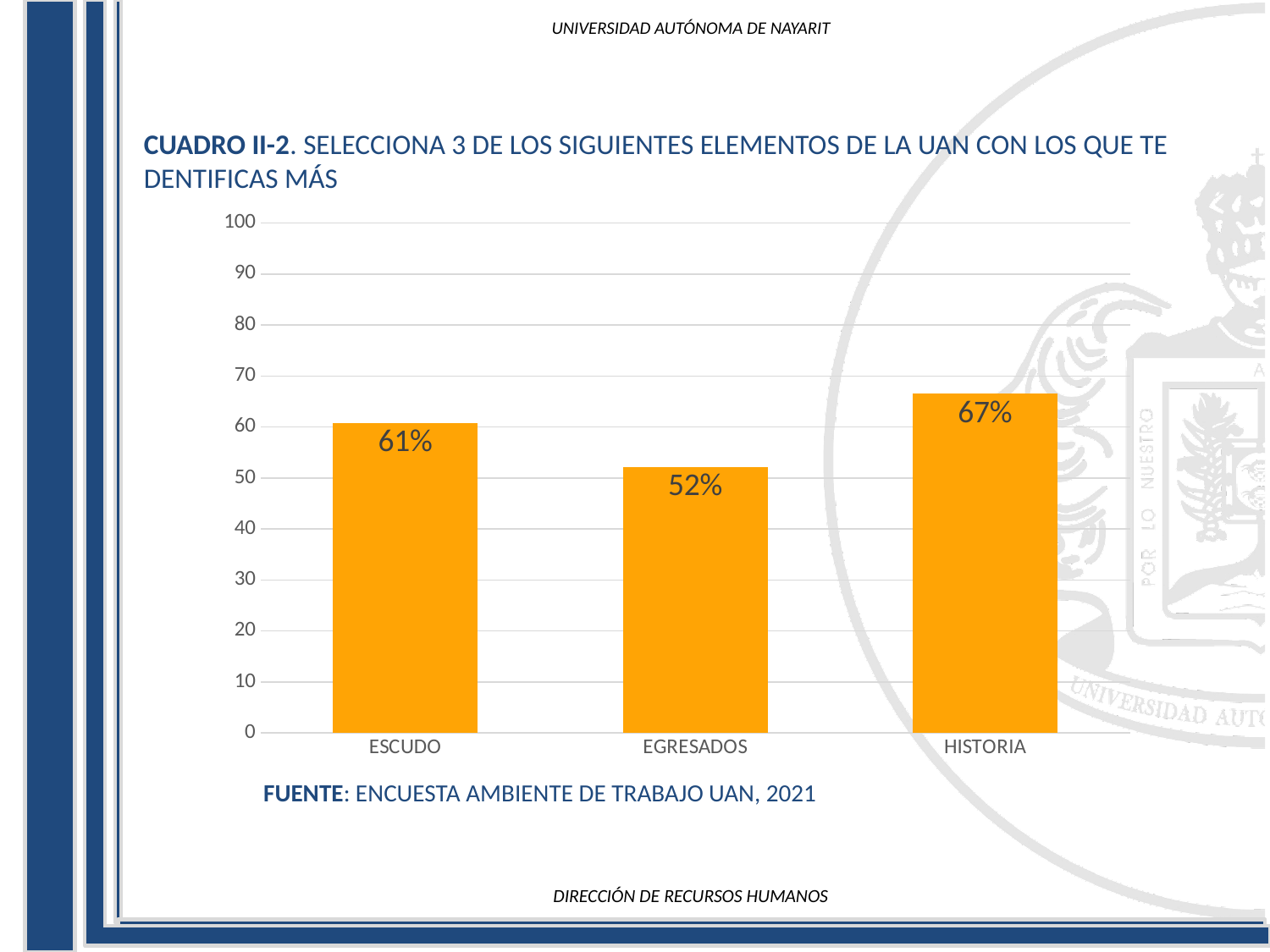
Which is larger, the value for ESCUDO or the value for HISTORIA? HISTORIA Which category has the lowest value? EGRESADOS What is the value for ESCUDO? 61% What kind of chart is shown on the slide? bar chart What is the value for HISTORIA? 67% Which category has the highest value? HISTORIA What source is cited below the chart? ENCUESTA AMBIENTE DE TRABAJO UAN, 2021 What is the value for EGRESADOS? 52% Is the value for EGRESADOS greater or less than 60? less What is the difference between the values for ESCUDO and EGRESADOS? 9% What is the difference between the values for HISTORIA and EGRESADOS? 15% How many categories are shown on the x axis? 3